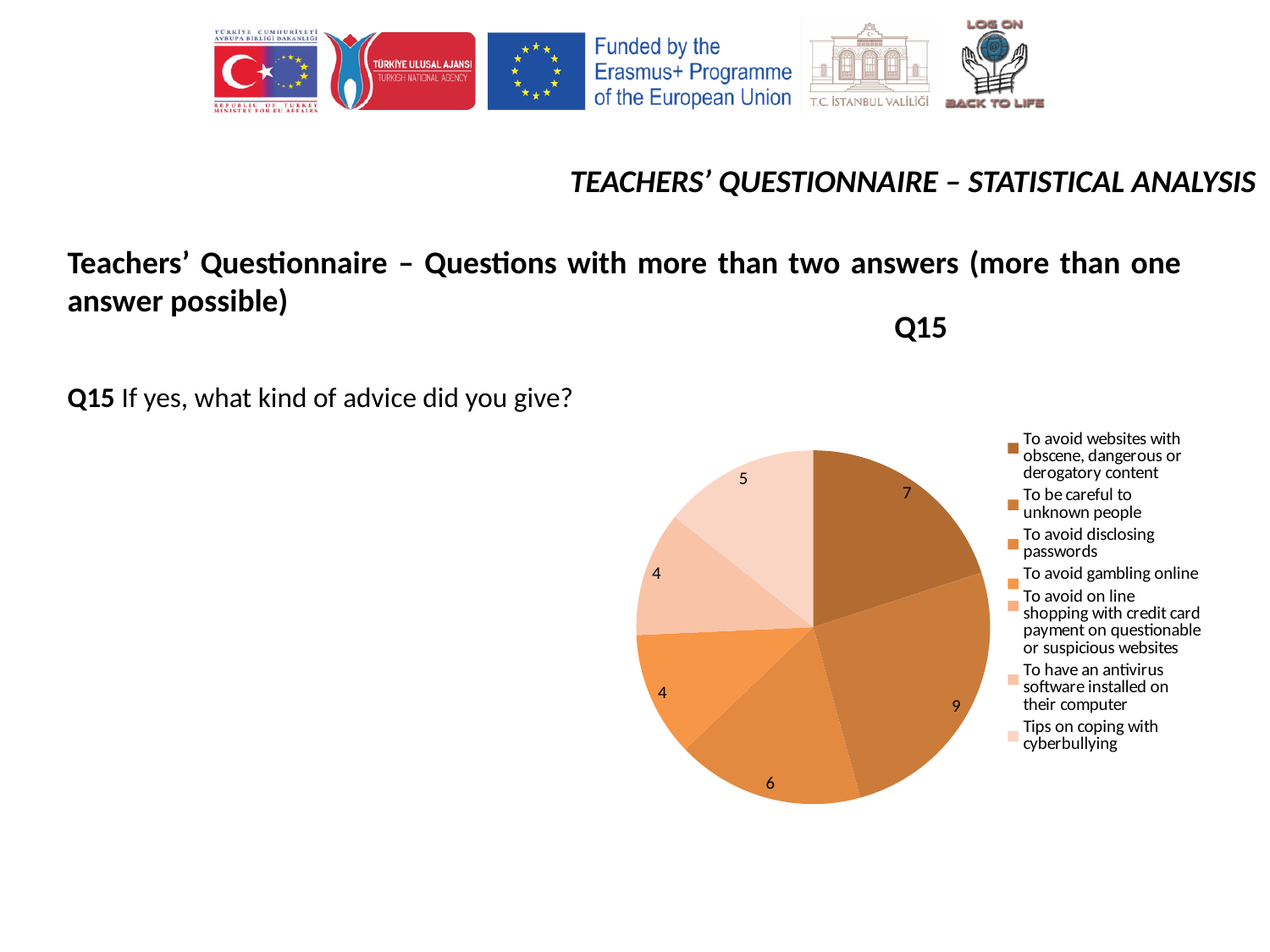
What is the difference between the values for 'To be careful to unknown people' and 'To avoid disclosing passwords'? 3 What is the value for 'To be careful to unknown people'? 9 Which is larger: 'To avoid disclosing passwords' or 'Tips on coping with cyberbullying'? To avoid disclosing passwords What type of chart is shown on the slide? Pie chart Which category has the largest slice of the pie? To be careful to unknown people What is the difference between the values for 'To be careful to unknown people' and 'To avoid websites with obscene, dangerous or derogatory content'? 2 How many categories does the chart's legend list? 7 What is the value for 'To avoid disclosing passwords'? 6 What share of the pie does 'To avoid websites with obscene, dangerous or derogatory content' represent? 20% What is the value for 'To avoid websites with obscene, dangerous or derogatory content'? 7 What is the title of the chart? Q15 What is the value for 'Tips on coping with cyberbullying'? 5